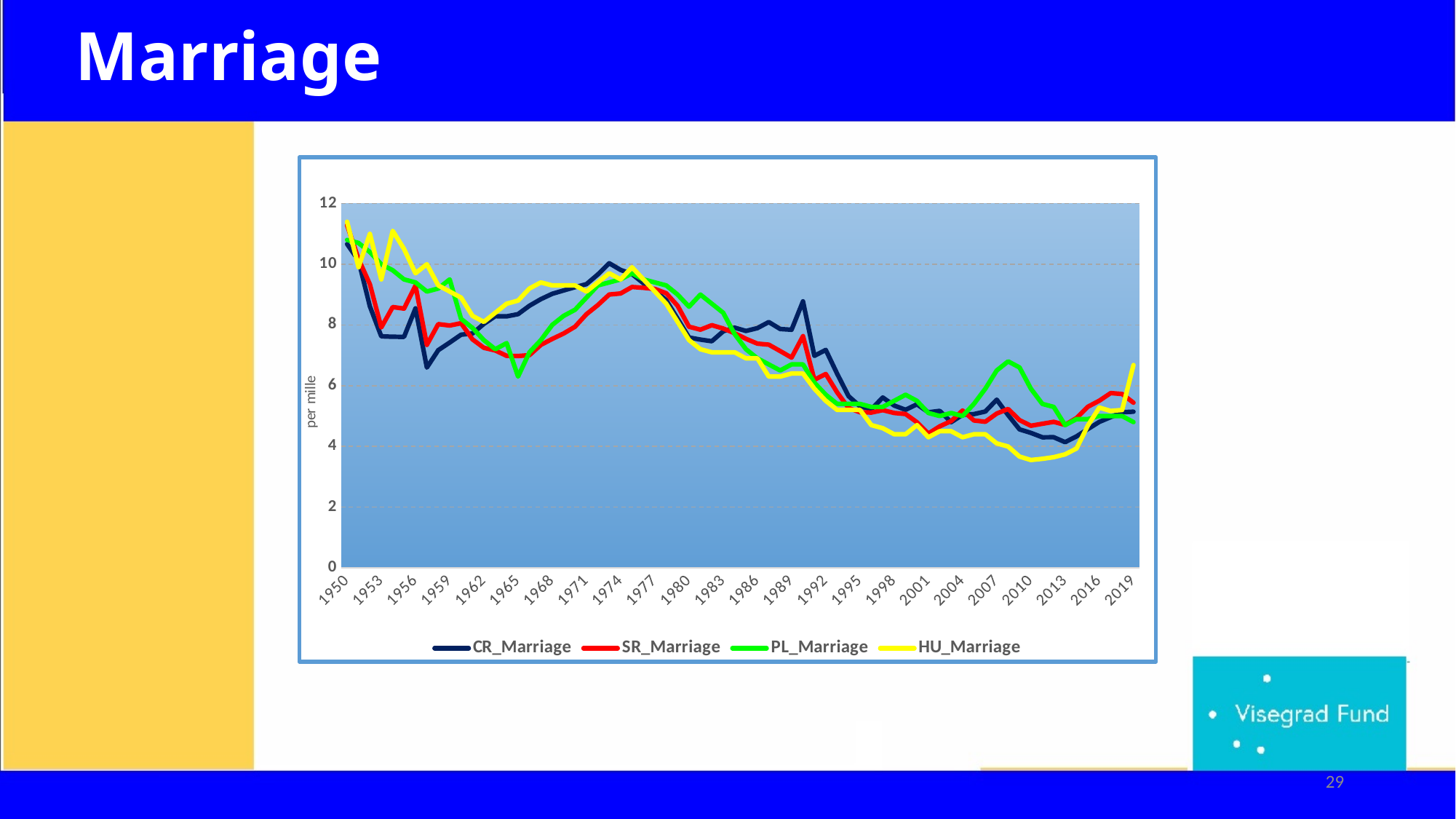
Is the value for HU_Marriage in 1950 greater or less than 10? greater In 1958, which is larger: CR_Marriage or HU_Marriage? HU_Marriage Which colour is used for the HU_Marriage line? yellow In 2010, which is larger: PL_Marriage or HU_Marriage? PL_Marriage What is the highest value shown on the vertical axis? 12 How many series does the legend list? 4 Overall, do the marriage rates rise or fall from 1950 to 2019? fall What is the label of the vertical axis? per mille Is the value for SR_Marriage in 2019 greater or less than 6? less What kind of chart is shown on the slide? line chart Is the value for HU_Marriage in 2010 greater or less than 4? less